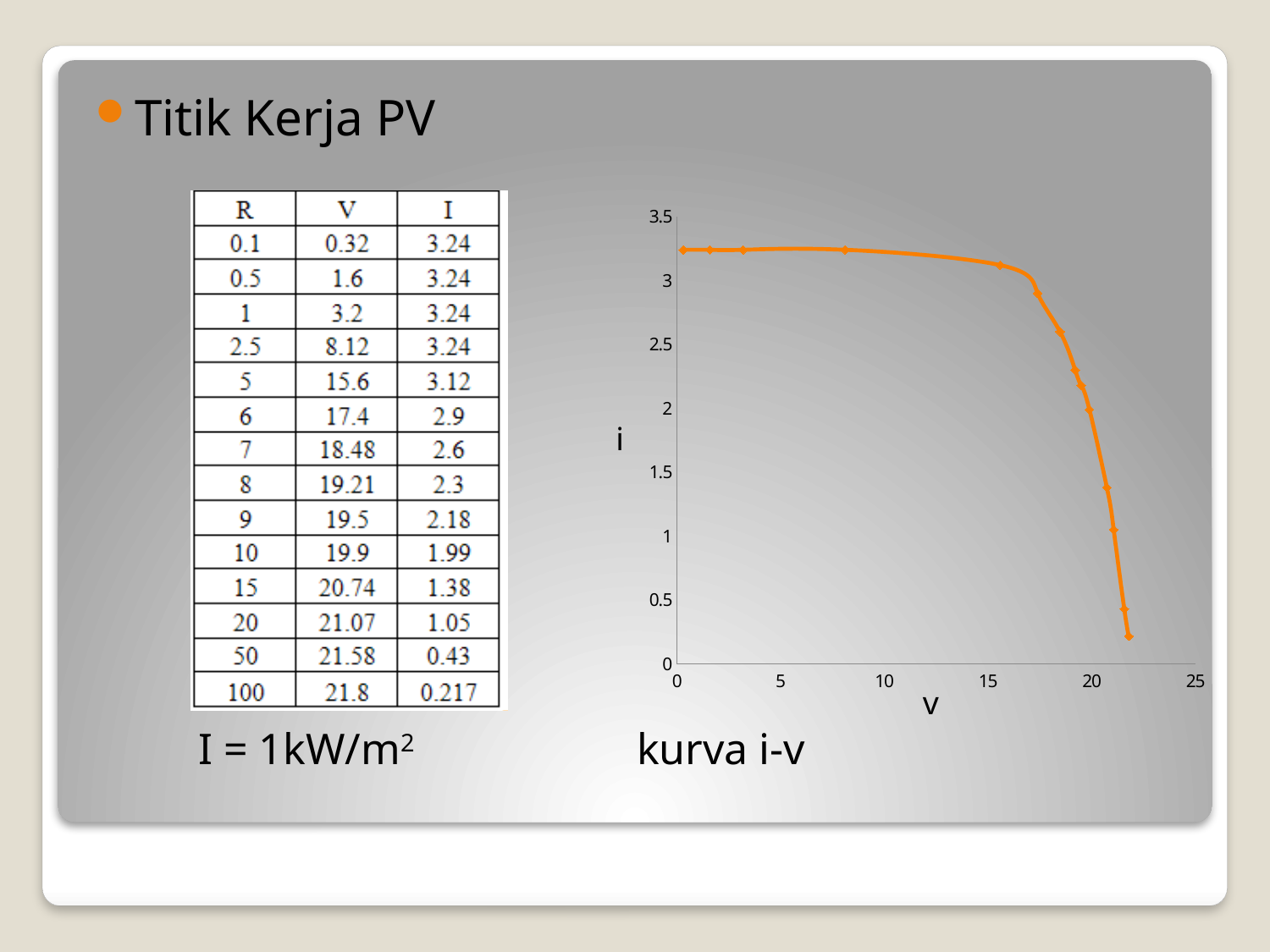
Is the value of i at the last plotted point (near v = 22) greater or less than 0.5? less According to the table on the slide, what is V when R is 100? 21.8 Is the value of i at v = 20 greater or less than 2.5? less As v increases along the x axis, does the plotted i value rise or fall overall? fall According to the table on the slide, what is I when V is 19.5? 2.18 How many lines are plotted on the chart? 1 Is the value of i at v = 10 greater or less than 3? greater What kind of chart is shown on the slide? line chart What is the label of the x axis of the chart? v What caption is written below the chart? kurva i-v